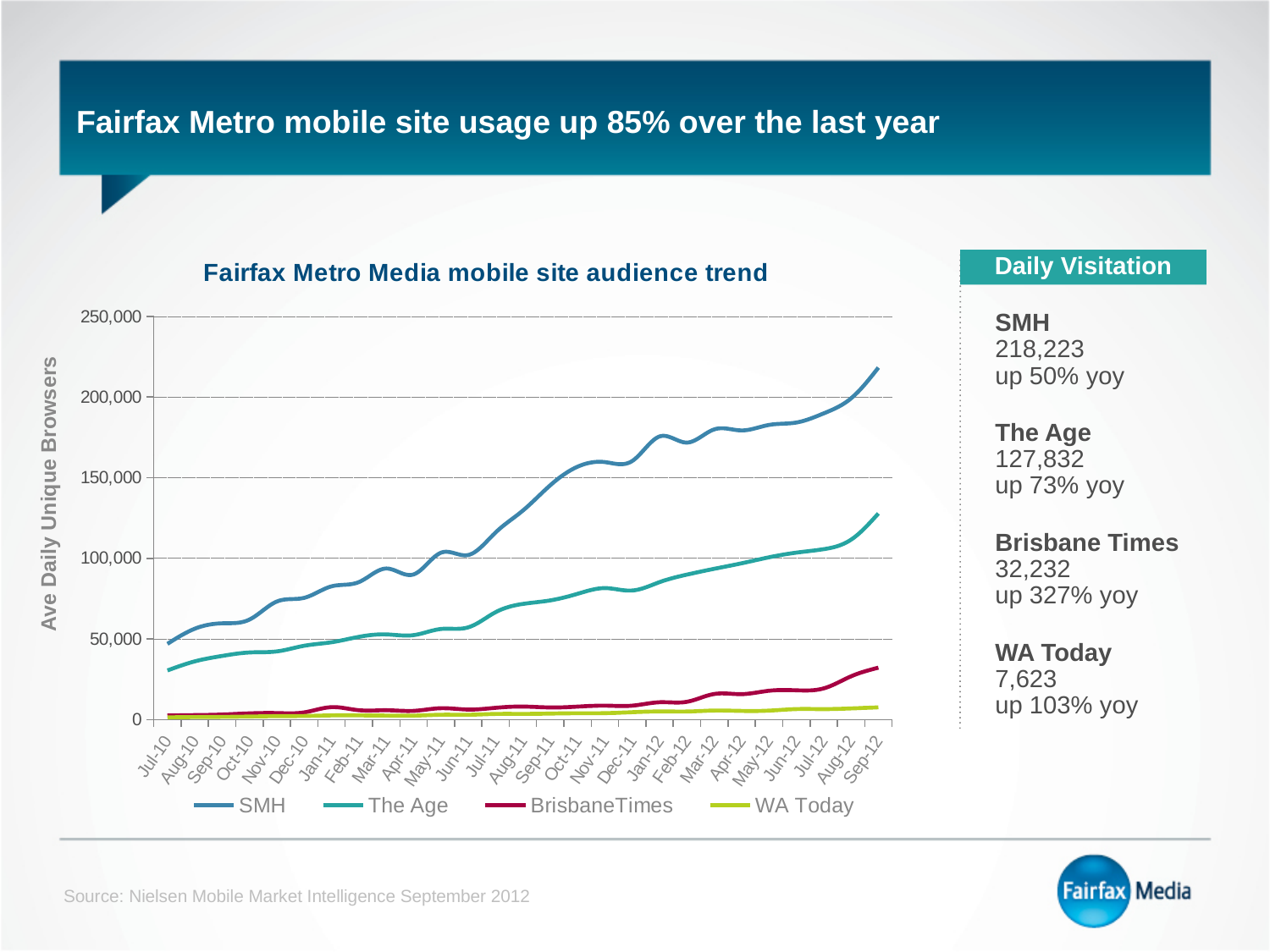
According to the Daily Visitation panel, what is the Brisbane Times value at Sep-12? 32,232 What kind of chart is shown on the slide? line chart According to the Daily Visitation panel, what is the SMH value at Sep-12? 218,223 Which series has the lowest value across the chart? WA Today Is the value for The Age at Jul-10 greater or less than 50,000? less How many monthly points are shown along the x axis of the chart? 27 What is the label on the y axis of the chart? Ave Daily Unique Browsers Does the SMH line rise or fall from Jul-10 to Sep-12? rise Is the value for SMH at Jan-12 greater or less than 150,000? greater What is the difference between the SMH and The Age values at Sep-12, using the figures in the Daily Visitation panel? 90,391 Which series has the highest value at Sep-12? SMH How many series does the chart legend list? 4